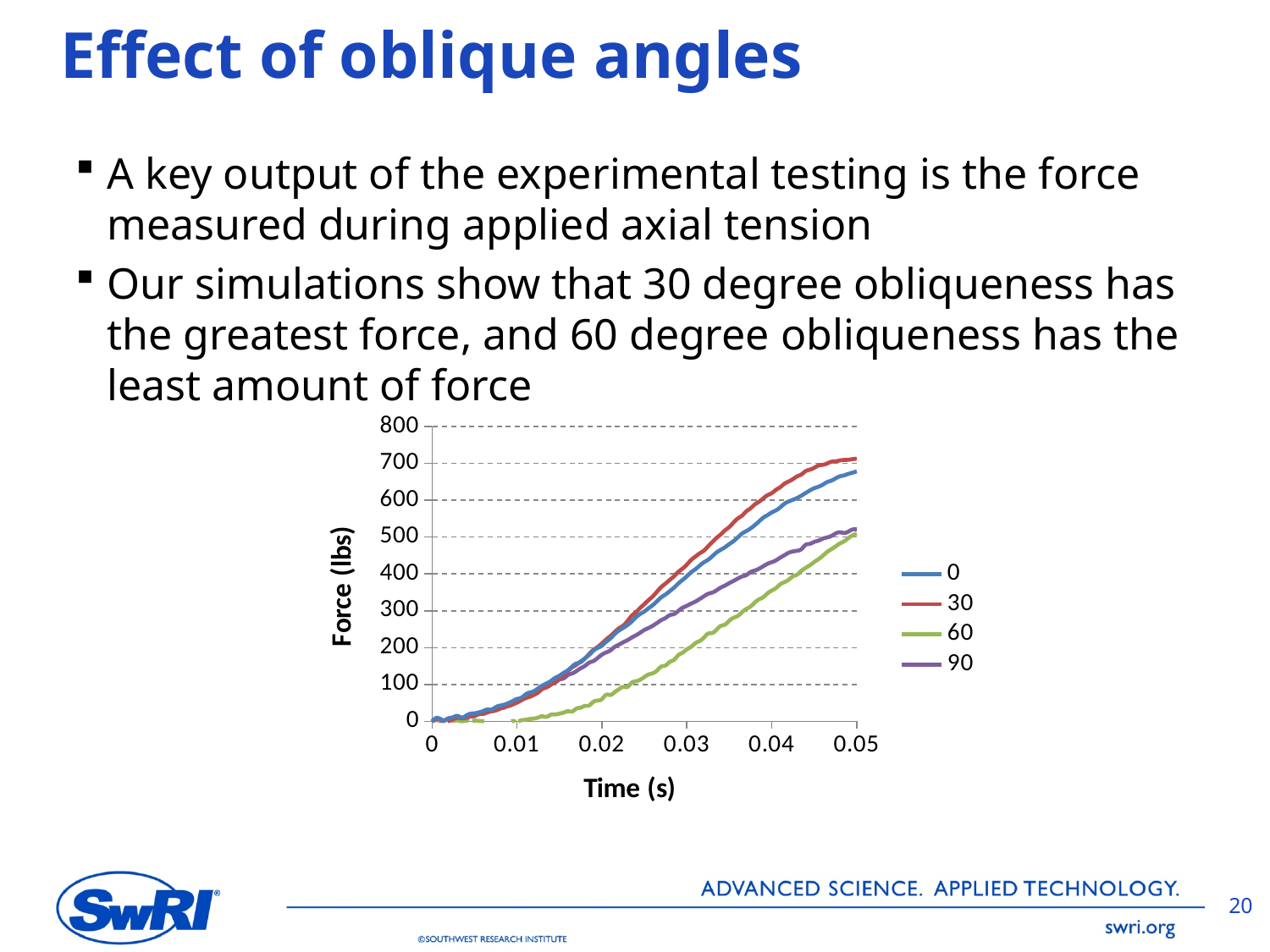
At 0.04 s, which series has the larger force, 0 or 90? 0 Is the force for the 60 series at 0.02 s greater or less than 100? less What is the label of the vertical axis? Force (lbs) What kind of chart is shown on the slide? Line chart Which series reaches the highest force at the end of the time range? 30 How many series does the legend list? 4 At 0.03 s, which series has the larger force, 30 or 60? 30 Is the force for the 30 series at 0.05 s greater or less than 600? greater What are the series names listed in the legend? 0, 30, 60, 90 Do the force values rise or fall as time increases? Rise Which series has the lowest force over most of the time range? 60